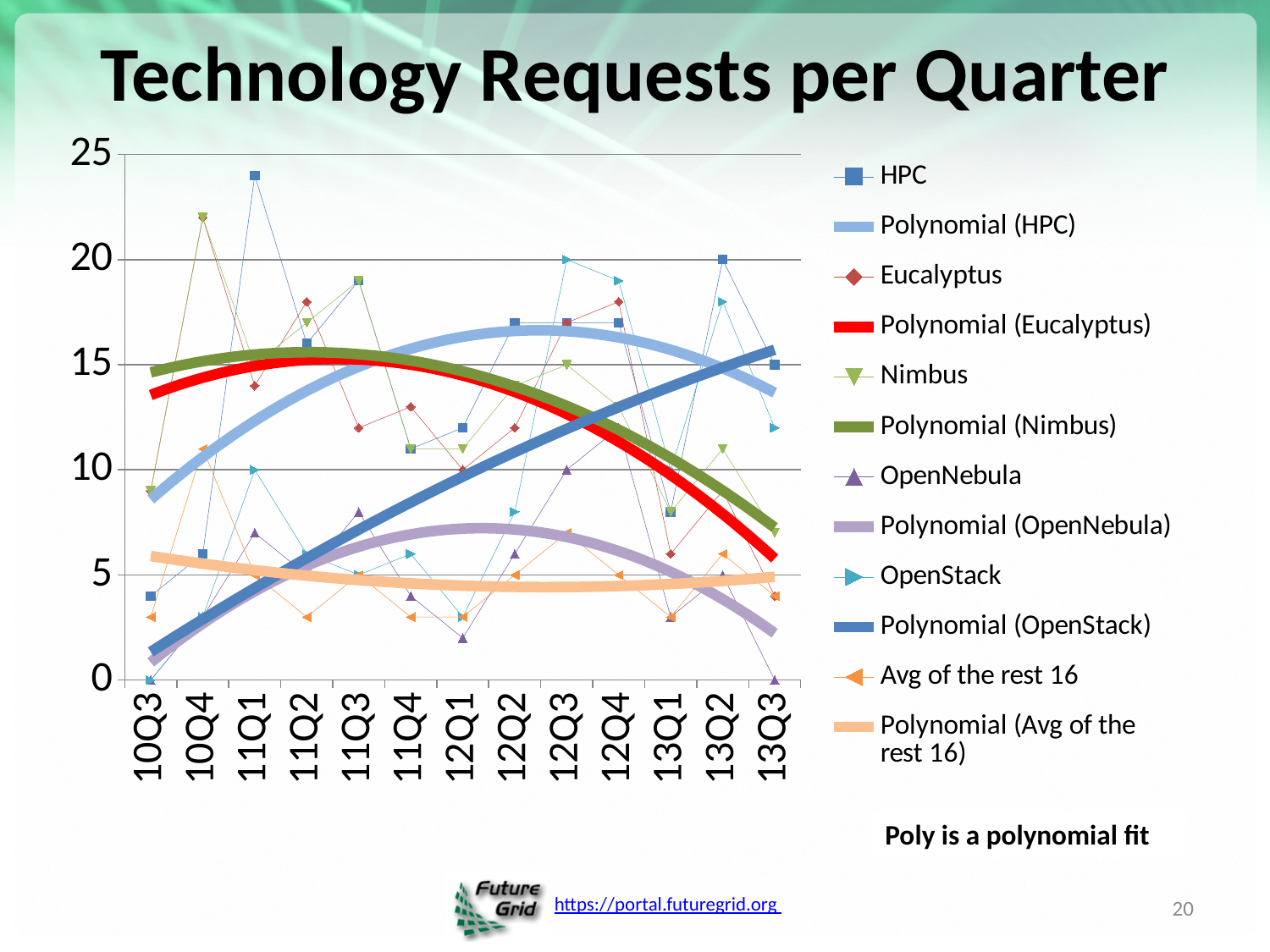
Which series reaches the highest single value on the chart? HPC Is the value for HPC in 11Q1 greater or less than 20? greater What kind of chart is shown on the slide? line chart Is the value for Nimbus in 10Q4 greater or less than 20? greater Is the value for OpenNebula in 12Q1 greater or less than 5? less What is the title of the chart? Technology Requests per Quarter Does the Polynomial (OpenStack) trend line rise or fall from 10Q3 to 13Q3? rises How many entries does the legend list? 12 How many quarters are shown on the x axis? 13 In which quarter does HPC reach its highest value? 11Q1 What is the value for OpenStack in 10Q3? 0